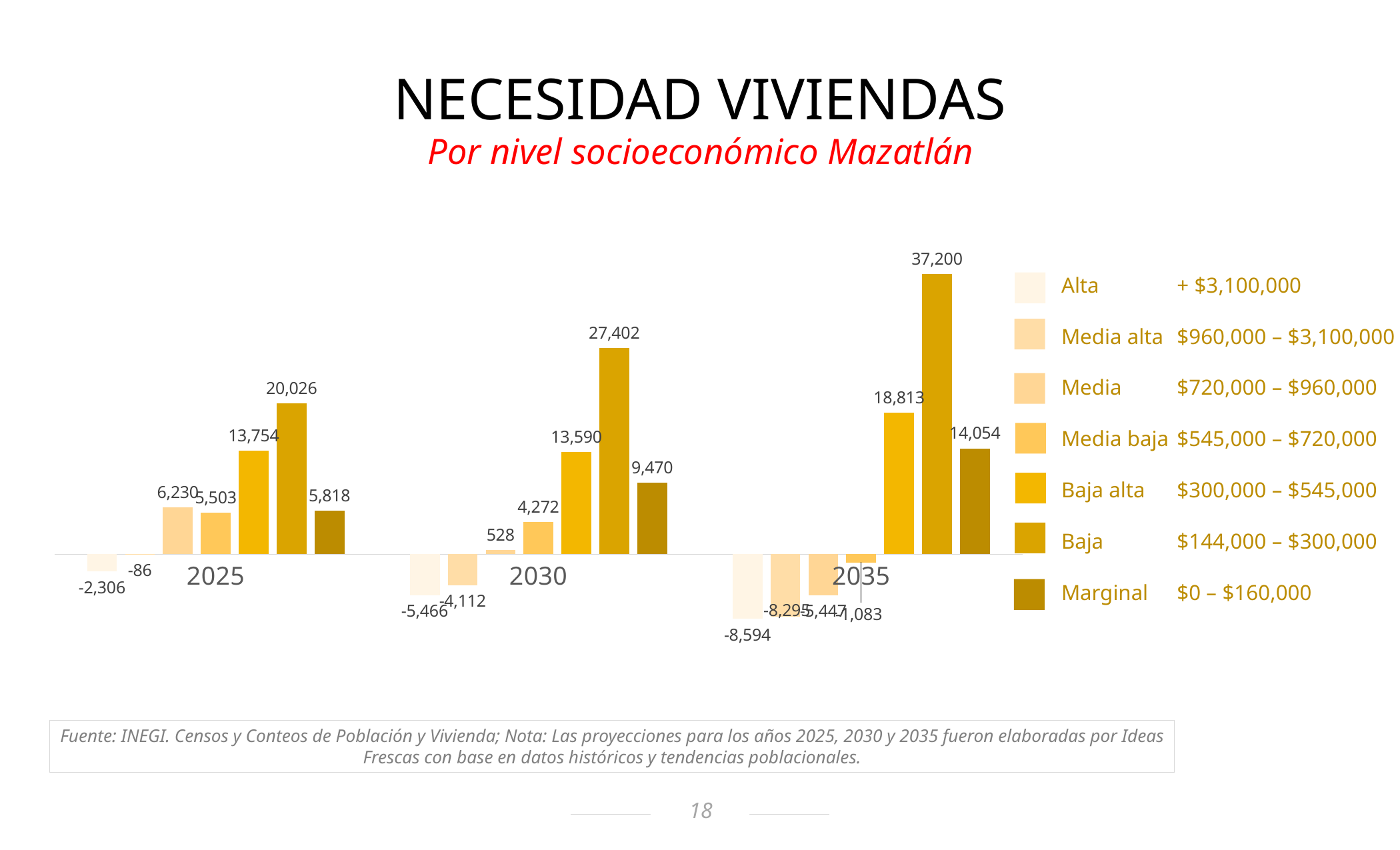
What kind of chart is shown on the slide? Bar chart Which socioeconomic level has the highest value in 2030? Baja How many series does the legend list? 7 What is the value for Alta in 2025? -2,306 What is the difference between the Baja value in 2035 and the Baja value in 2030? 9,798 How many years are shown on the x axis? 3 Which socioeconomic level has the lowest value in 2035? Alta Do the values for Baja rise or fall from 2025 to 2035? Rise Is the Baja alta value larger in 2025 or in 2030? 2025 What is the value for Marginal in 2030? 9,470 What is the value for Baja in 2035? 37,200 What price range does the legend give for Baja alta? $300,000 – $545,000